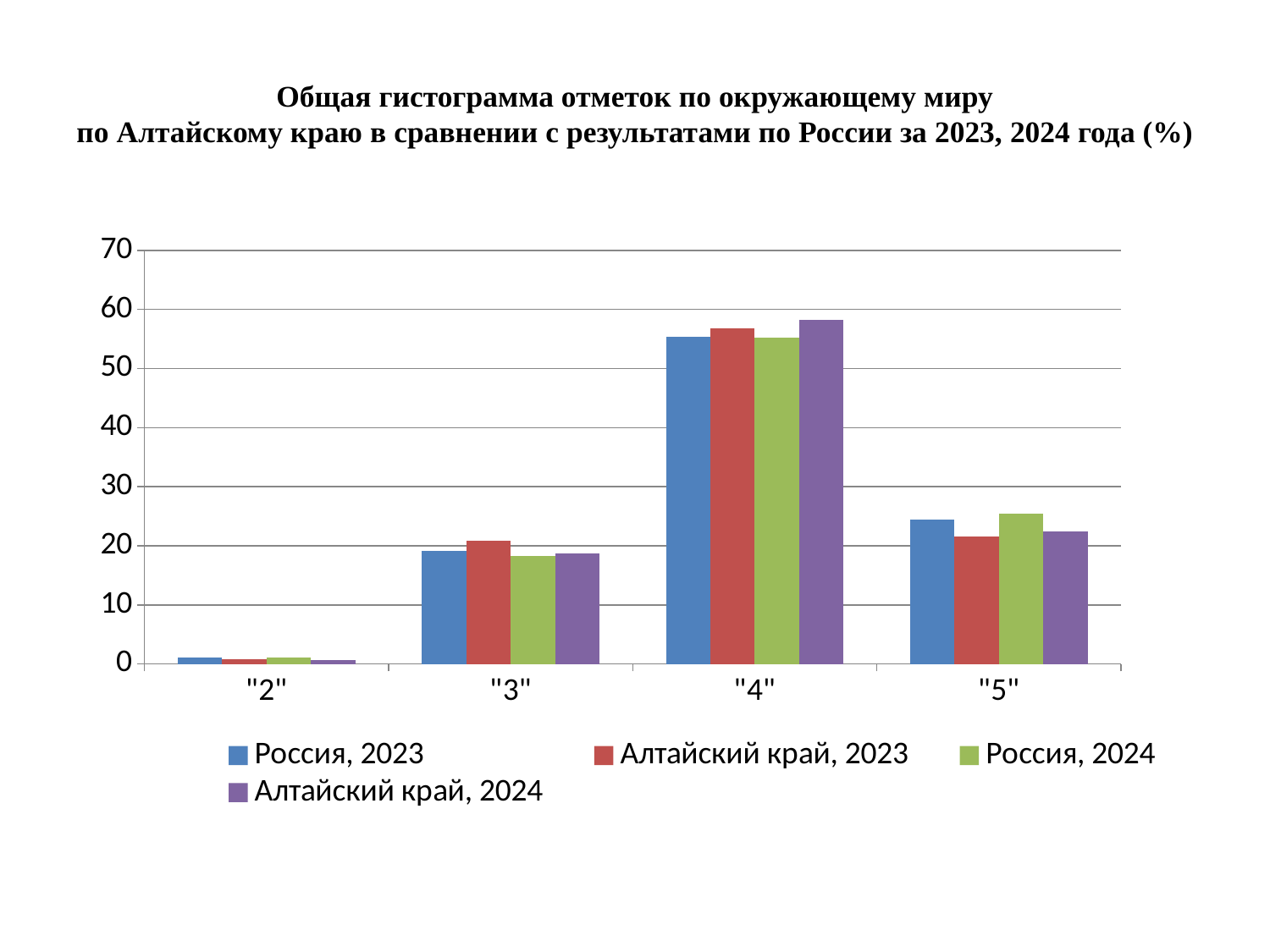
How many grade categories are shown on the x axis? 4 Is the value for Россия, 2023 at grade "3" greater or less than 10? greater Is the value for Алтайский край, 2024 at grade "5" greater or less than 30? less Is the value for Россия, 2023 at grade "4" greater or less than 50? greater At grade "4", which is larger: Алтайский край, 2024 or Россия, 2024? Алтайский край, 2024 What kind of chart is shown on the slide? bar chart Which grade category has the lowest bars? "2" How many series does the legend list? 4 Which series is shown in red in the legend? Алтайский край, 2023 At grade "5", which is larger: Россия, 2024 or Алтайский край, 2023? Россия, 2024 Which grade category has the highest bars? "4" What colour represents the series Алтайский край, 2024 in the legend? purple